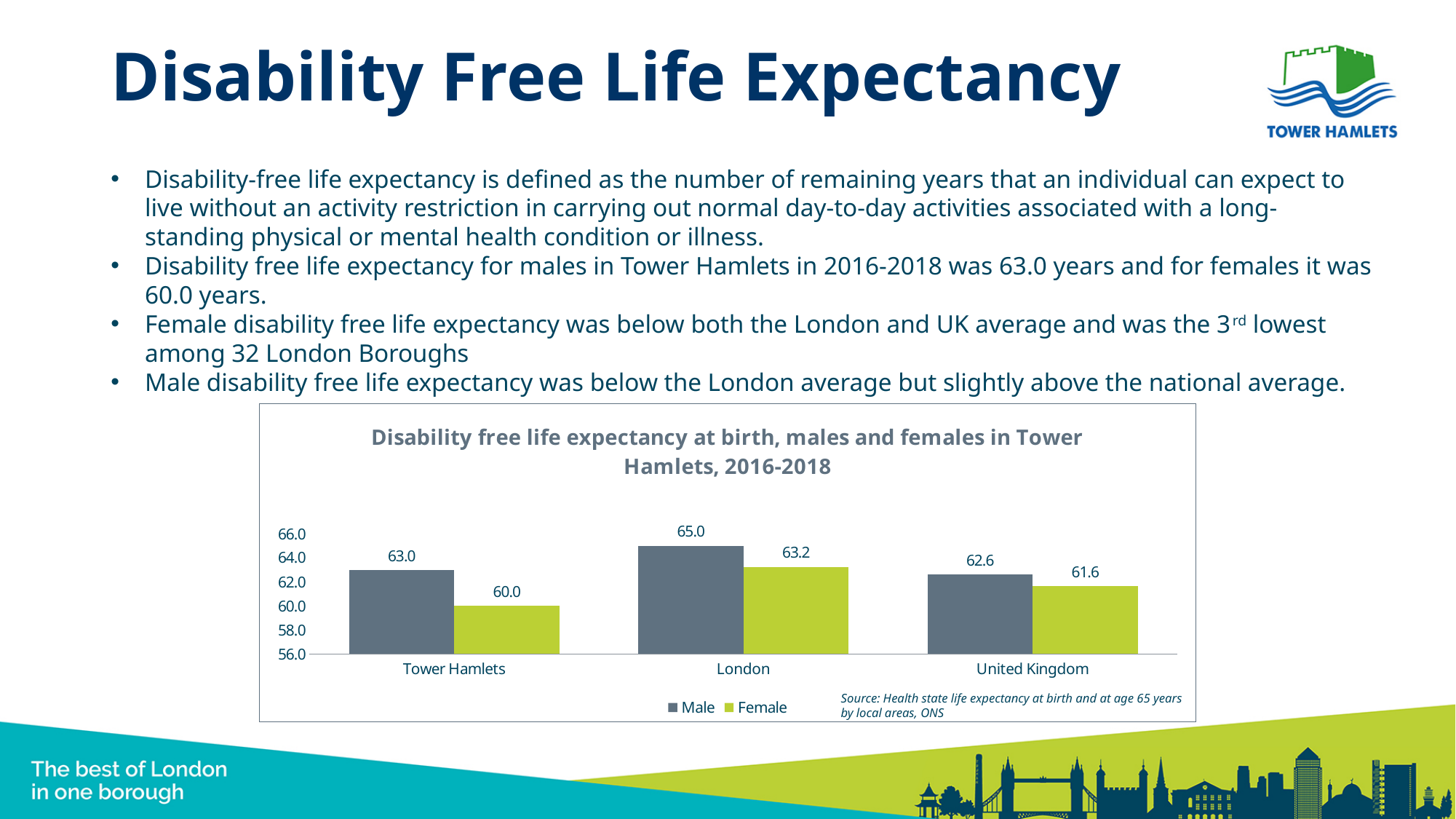
Which area has the highest Male value? London What is the Female value for United Kingdom? 61.6 Which is larger: the Female value for London or the Male value for United Kingdom? Female value for London What is the Female disability free life expectancy value for London? 63.2 What kind of chart is shown? Bar chart What is the difference between the Male values for London and United Kingdom? 2.4 Which area has the lowest Female value? Tower Hamlets Is the Female value for Tower Hamlets greater or less than 62.0? less How many areas are shown on the x axis? 3 What is the difference between the Male and Female values for Tower Hamlets? 3.0 How many series does the legend list? 2 What is the Male disability free life expectancy value for Tower Hamlets? 63.0